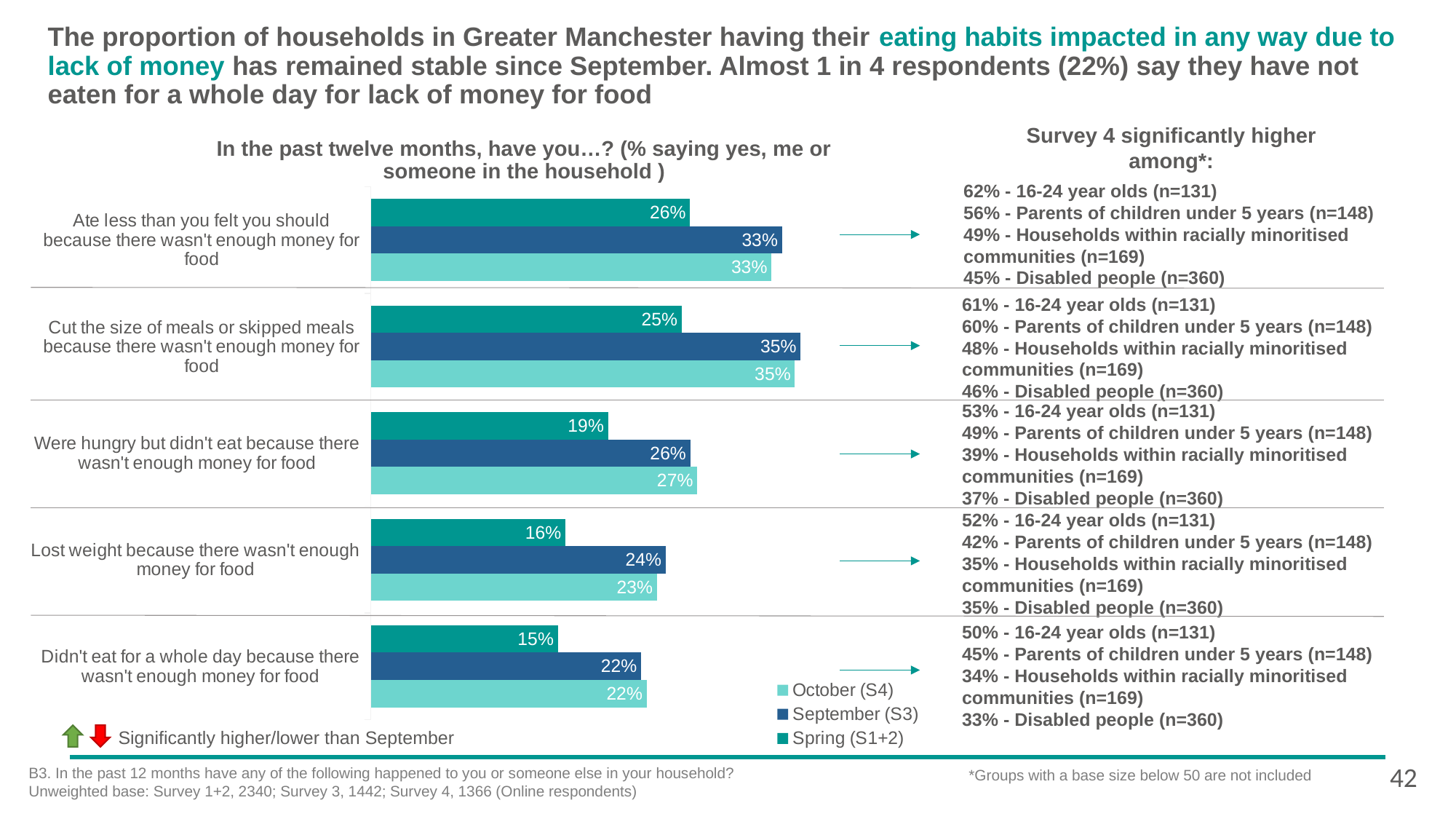
What is the September (S3) value for 'Lost weight because there wasn't enough money for food'? 24% What is the October (S4) value for 'Cut the size of meals or skipped meals because there wasn't enough money for food'? 35% Which category has the highest October (S4) value? Cut the size of meals or skipped meals because there wasn't enough money for food How many categories (survey items) are plotted in the chart? 5 What is the Spring (S1+2) value for 'Ate less than you felt you should because there wasn't enough money for food'? 26% Which category has the lowest Spring (S1+2) value? Didn't eat for a whole day because there wasn't enough money for food How many series does the chart legend list? 3 Which series is shown in the darkest blue colour in the chart? September (S3) What kind of chart is shown on the slide? bar chart What is the difference between the September (S3) and Spring (S1+2) values for 'Cut the size of meals or skipped meals because there wasn't enough money for food'? 10 percentage points For 'Were hungry but didn't eat because there wasn't enough money for food', which is larger: the October (S4) value or the Spring (S1+2) value? October (S4) What is the October (S4) value for 'Didn't eat for a whole day because there wasn't enough money for food'? 22%